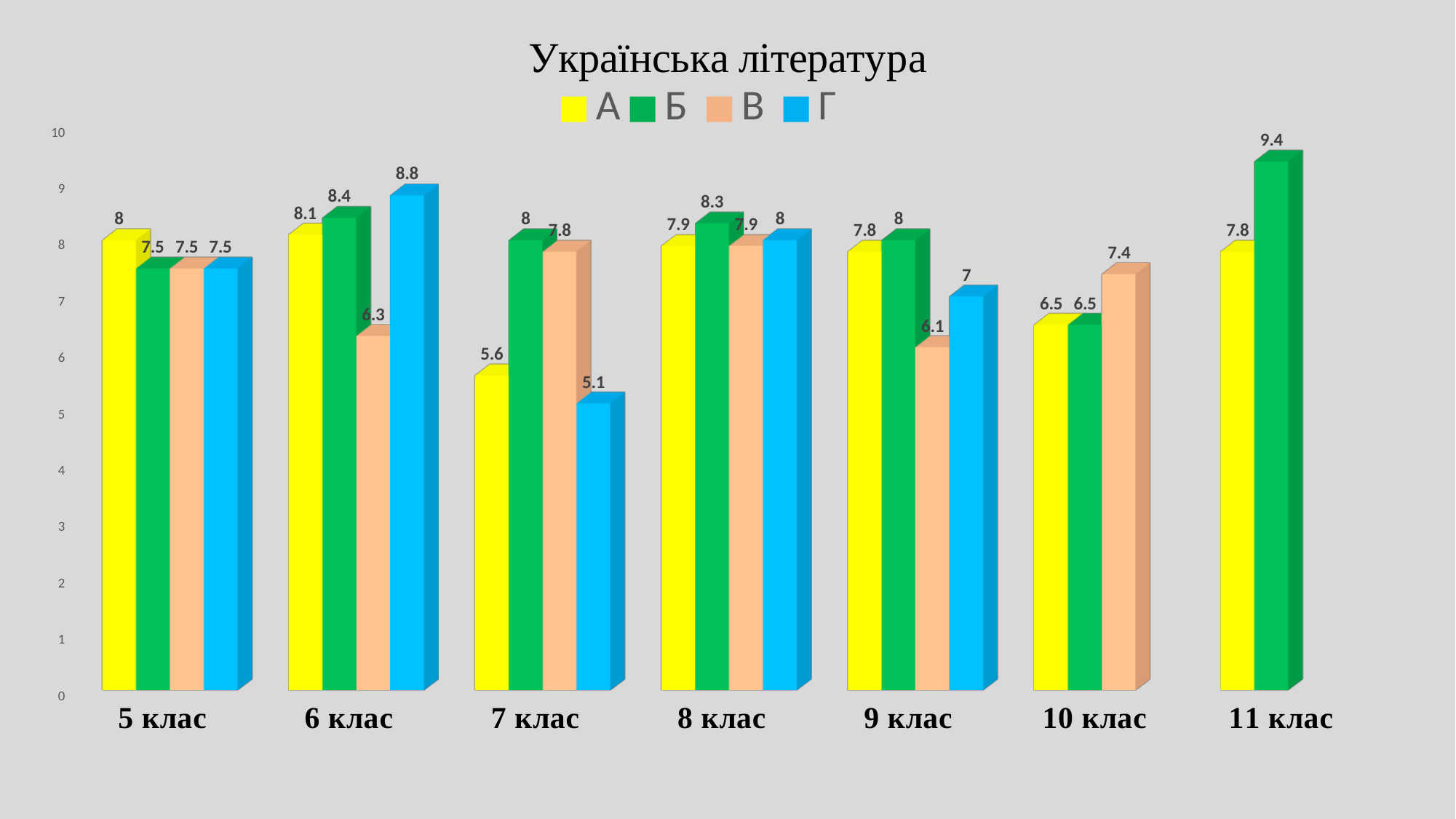
What is the difference between series Б and series В in 6 клас? 2.1 Which category has the highest value for series Б? 11 клас What is the title of the chart? Українська література What is the value for series А in 7 клас? 5.6 What kind of chart is this? bar chart What is the value for series В in 10 клас? 7.4 How many series does the legend list? 4 Which is larger in 9 клас: series В or series Г? Г Which category has the lowest value for series Г? 7 клас How many categories (classes) are shown on the x axis? 7 What is the value for series Г in 6 клас? 8.8 What is the difference between series Б and series Г in 7 клас? 2.9